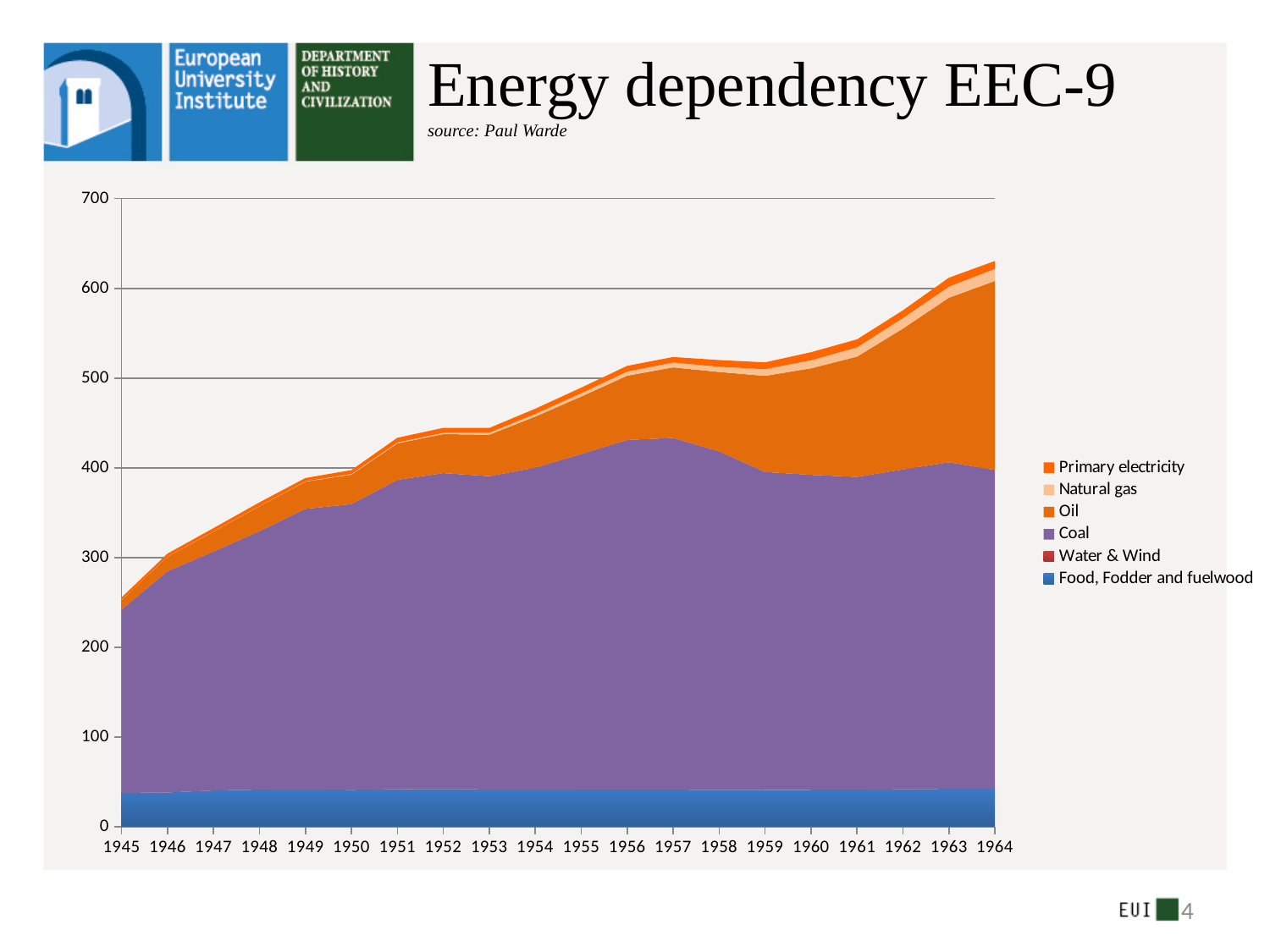
How many years are shown along the x axis? 20 Which series is shown in blue at the bottom of the stack? Food, Fodder and fuelwood In which year is the total energy value lowest? 1945 Is the total value for 1957 greater or less than 500? greater Which is larger, the total value for 1951 or the total value for 1947? 1951 How many series does the legend list? 6 Is the total value for 1945 greater or less than 300? less Is the total value for 1964 greater or less than 600? greater In which year is the total energy value highest? 1964 What is the title of the chart? Energy dependency EEC-9 Does the total energy value rise or fall from 1945 to 1964? rise What kind of chart is shown on the slide? stacked area chart